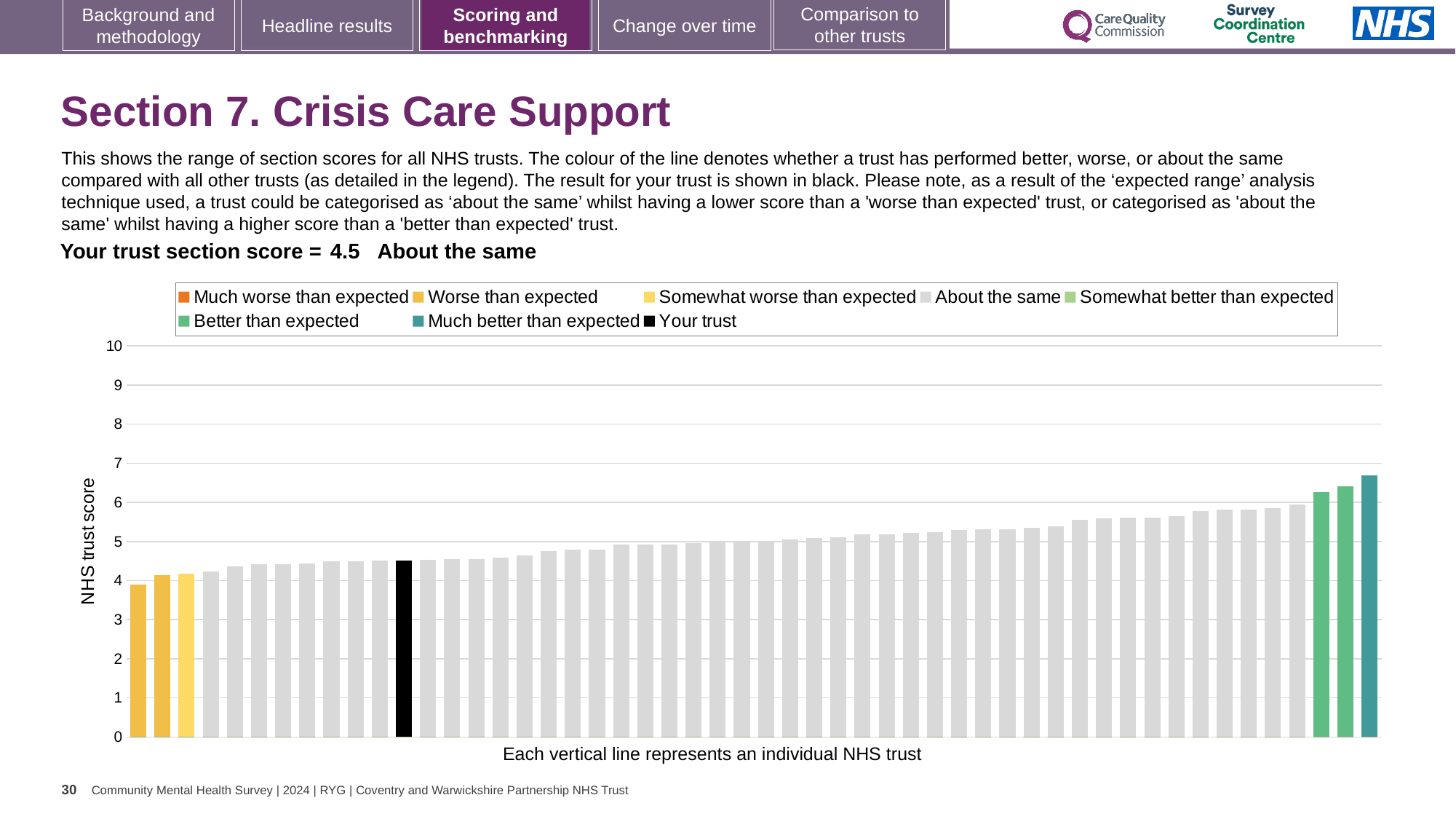
What is the section score for your trust shown on the slide? 4.5 Is the value of the tallest bar (rightmost trust) greater or less than 6? greater Do the bar values rise or fall moving from left to right along the x axis? rise Is the value for your trust (the black bar) greater or less than 5? less How many bars are coloured teal (Much better than expected)? 1 How many entries does the chart legend list? 8 What is the label on the vertical axis of the chart? NHS trust score What kind of chart is shown on the slide? bar chart Is the value of the shortest bar (leftmost trust) greater or less than 5? less What colour is the bar representing your trust? black Which is larger: the value for your trust (black bar) or the value of the rightmost bar? the rightmost bar